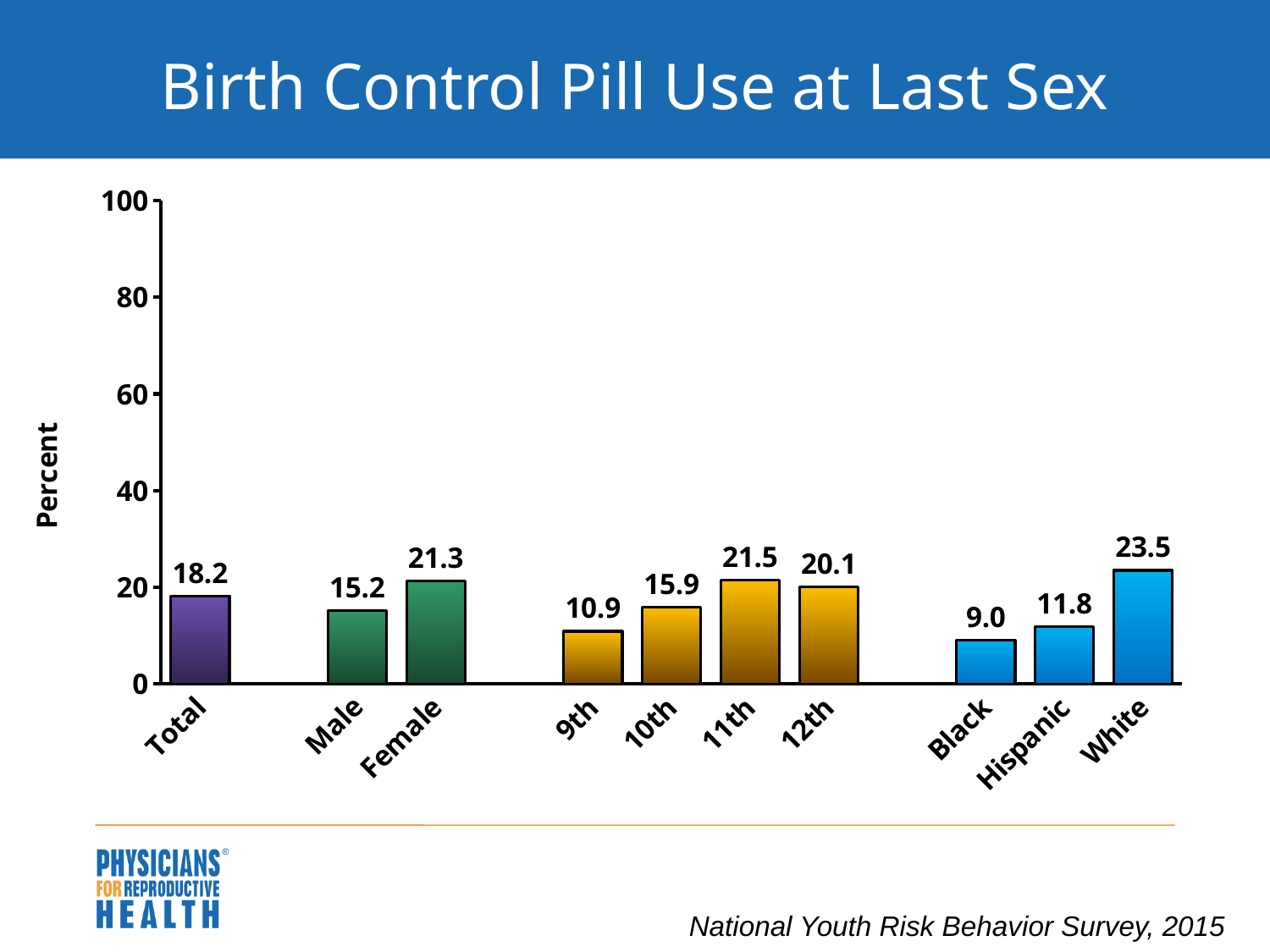
What is the value for Total? 18.2 Is the value for White greater or less than 20? greater How many bars are shown in the chart? 10 Which category has the lowest value? Black What is the value for Hispanic? 11.8 What is the value for Female? 21.3 What is the title of the chart? Birth Control Pill Use at Last Sex Which category has the highest value? White What is the difference between the Female and Male values? 6.1 What is the value for 9th grade? 10.9 Which is larger, the value for 11th grade or 12th grade? 11th What kind of chart is this? bar chart